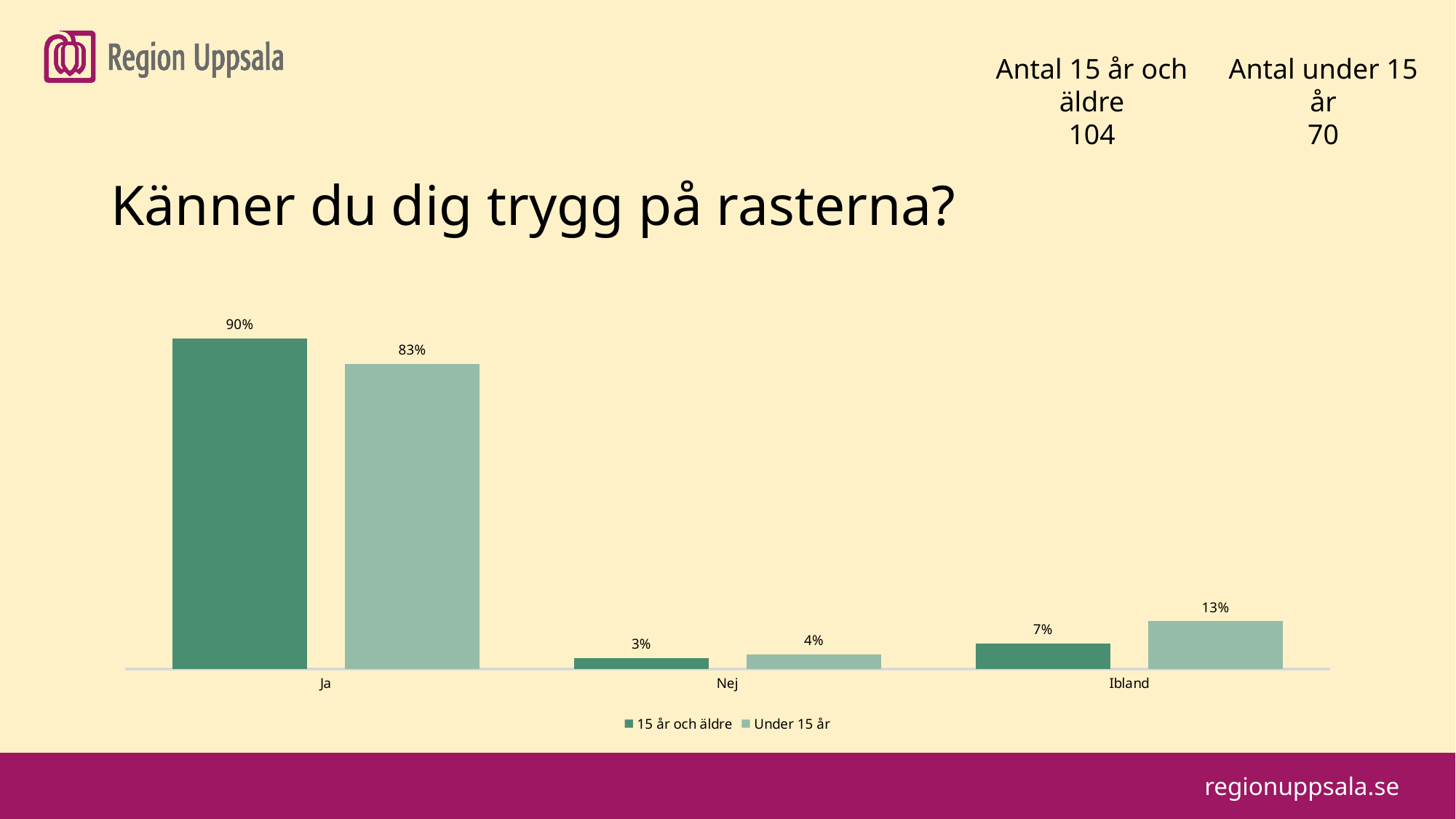
How many categories are shown on the x axis? 3 What is the title of the question shown above the chart? Känner du dig trygg på rasterna? Which category has the lowest value for the "Under 15 år" series? Nej What is the value for "15 år och äldre" in the "Ja" category? 90% How many series does the legend list? 2 What is the difference between the "Under 15 år" and "15 år och äldre" values in the "Ibland" category? 6% In the "Ibland" category, which series has the larger value? Under 15 år What is the value for "Under 15 år" in the "Ibland" category? 13% What is the value for "Under 15 år" in the "Nej" category? 4% What is the difference between the "15 år och äldre" and "Under 15 år" values in the "Ja" category? 7% What kind of chart is shown on the slide? Bar chart Which category has the highest value for the "15 år och äldre" series? Ja